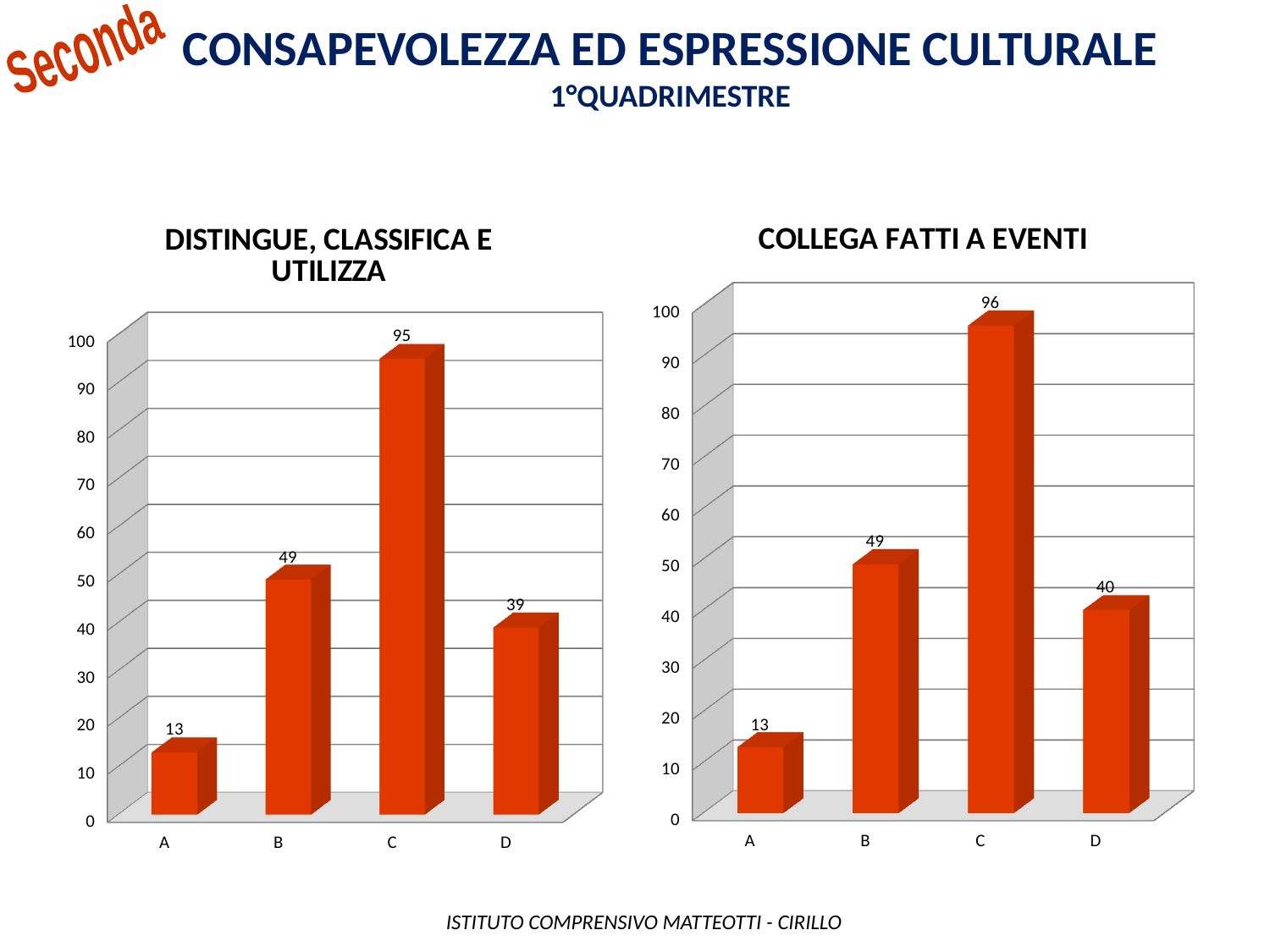
In the chart titled 'COLLEGA FATTI A EVENTI', is the value for D greater or less than 50? less How many categories are shown on the x axis of the chart titled 'COLLEGA FATTI A EVENTI'? 4 In the chart titled 'DISTINGUE, CLASSIFICA E UTILIZZA', what is the difference between the values for C and B? 46 In the chart titled 'COLLEGA FATTI A EVENTI', what is the difference between the values for B and A? 36 What is the title of the chart on the right side of the slide? COLLEGA FATTI A EVENTI In the chart titled 'DISTINGUE, CLASSIFICA E UTILIZZA', what is the value for category C? 95 In the chart titled 'COLLEGA FATTI A EVENTI', what is the value for category D? 40 In the chart titled 'DISTINGUE, CLASSIFICA E UTILIZZA', which category has the lowest value? A In the chart titled 'COLLEGA FATTI A EVENTI', which category has the highest value? C What kind of chart is the chart titled 'DISTINGUE, CLASSIFICA E UTILIZZA'? bar chart In the chart titled 'DISTINGUE, CLASSIFICA E UTILIZZA', which is larger, the value for B or the value for D? B In the chart titled 'DISTINGUE, CLASSIFICA E UTILIZZA', what is the value for category A? 13